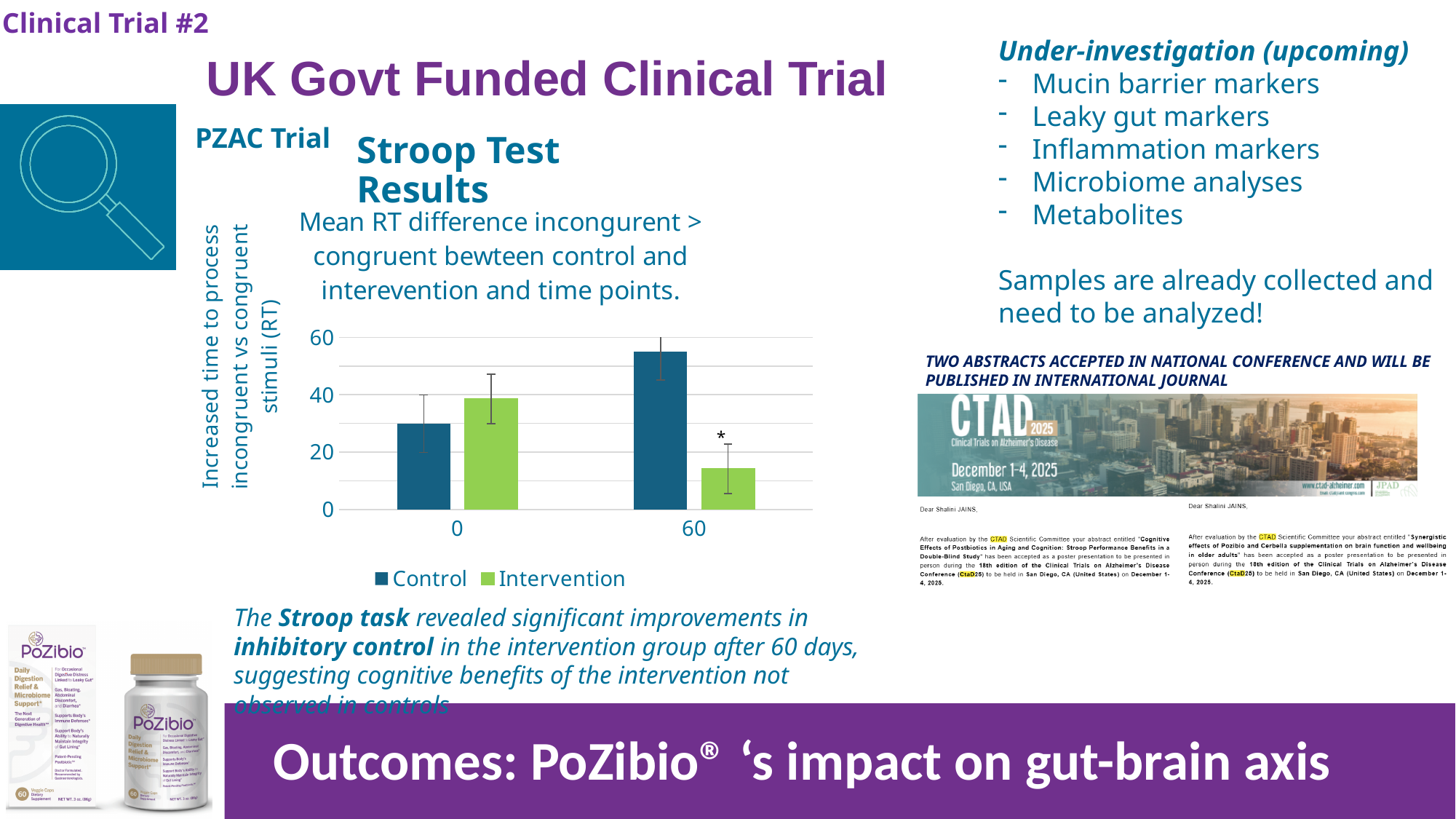
Which series and time point has the tallest bar in the Stroop Test Results chart? Control at 60 At time point 60, which is larger, the Control bar or the Intervention bar? Control Which series is shown in green in the Stroop Test Results chart? Intervention What kind of chart is shown under the 'Stroop Test Results' heading? bar chart Is the Control value at time point 0 greater or less than 20? greater Is the Intervention value at time point 60 greater or less than 20? less Does the Control series rise or fall from time point 0 to time point 60? rise Which series and time point has the shortest bar in the Stroop Test Results chart? Intervention at 60 How many series does the legend of the Stroop Test Results chart list? 2 How many time-point categories are shown on the x axis of the Stroop Test Results chart? 2 Is the Control value at time point 60 greater or less than 40? greater Does the Intervention series rise or fall from time point 0 to time point 60? fall